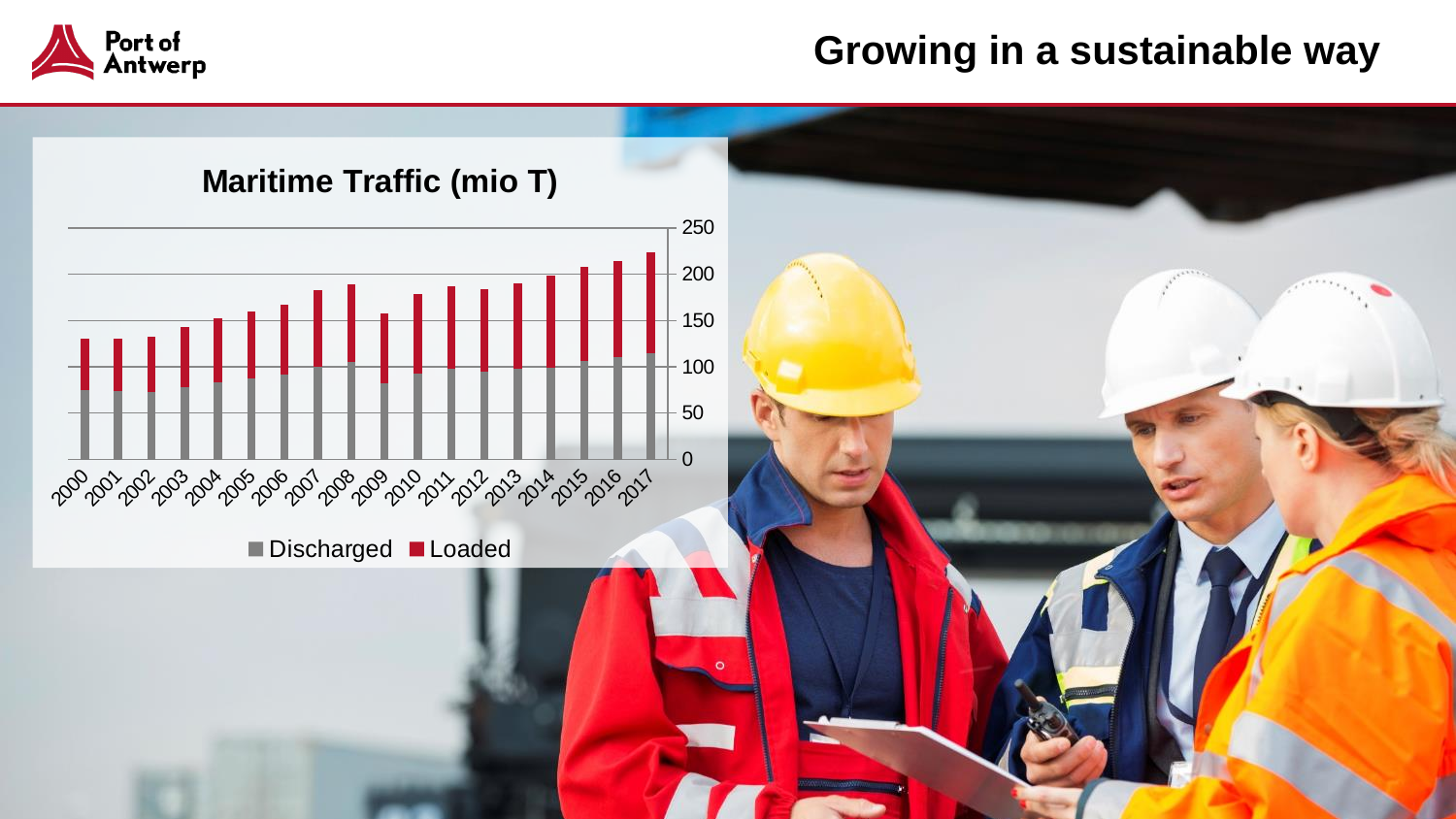
How many years are shown on the x axis? 18 What is the title of the chart? Maritime Traffic (mio T) What kind of chart is shown on the slide? stacked bar chart Is the total maritime traffic for 2017 greater or less than 200? greater Does total maritime traffic generally rise or fall from 2000 to 2017? rise Is the total maritime traffic for 2000 greater or less than 150? less Which year has the highest total maritime traffic? 2017 Is the Discharged value for 2000 greater or less than 100? less Which series are listed in the legend? Discharged and Loaded How many series does the legend list? 2 Which year has the larger total maritime traffic, 2008 or 2009? 2008